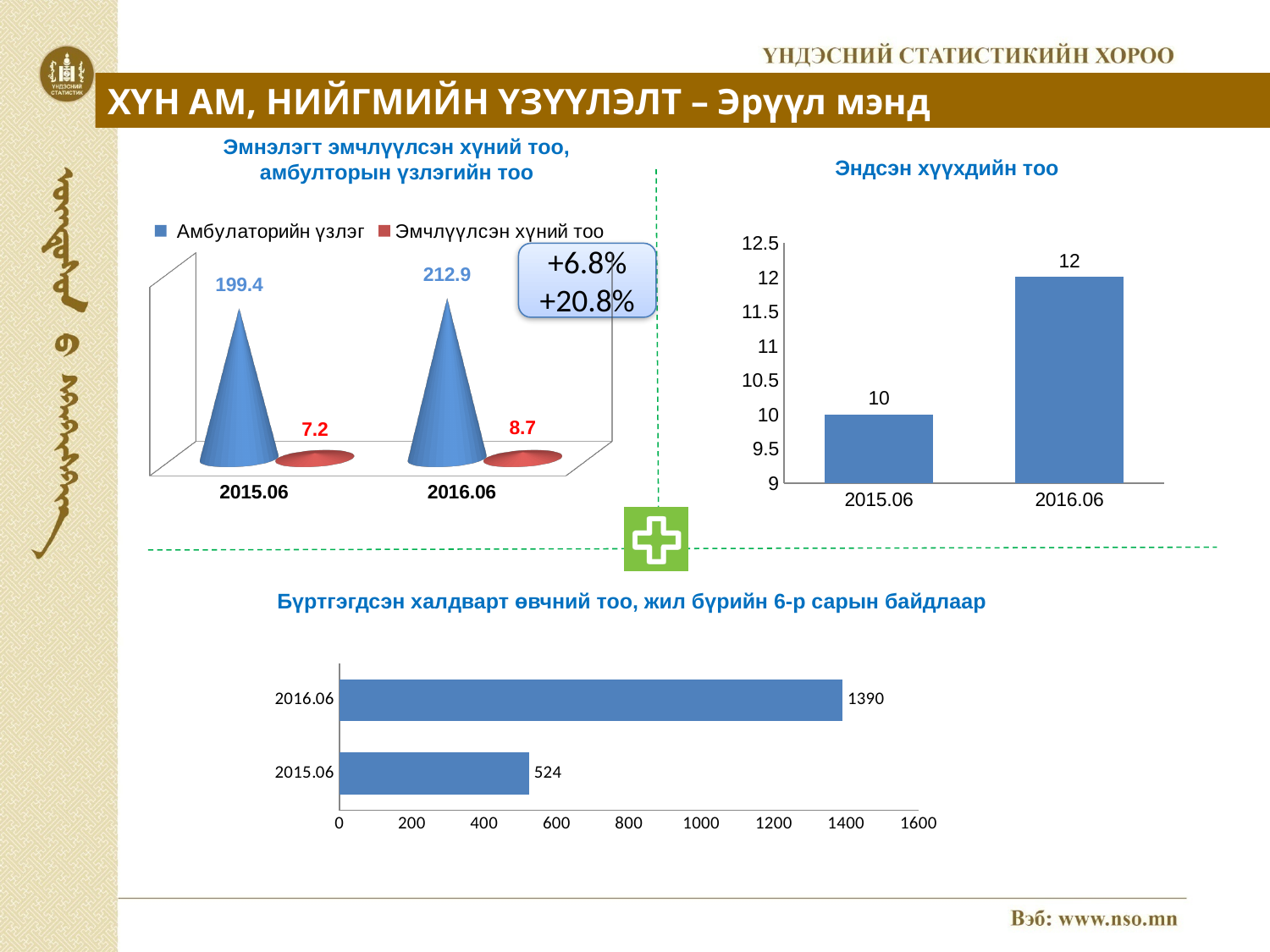
In the bottom chart titled 'Бүртгэгдсэн халдварт өвчний тоо, жил бүрийн 6-р сарын байдлаар', what is the value for 2015.06? 524 In the chart titled 'Эндсэн хүүхдийн тоо', what is the difference between the 2016.06 and 2015.06 values? 2 In the top-left chart titled 'Эмнэлэгт эмчлүүлсэн хүний тоо, амбулторын үзлэгийн тоо', what is the value of 'Эмчлүүлсэн хүний тоо' for 2015.06? 7.2 In the bottom chart titled 'Бүртгэгдсэн халдварт өвчний тоо, жил бүрийн 6-р сарын байдлаар', what is the value for 2016.06? 1390 In the top-left chart titled 'Эмнэлэгт эмчлүүлсэн хүний тоо, амбулторын үзлэгийн тоо', what is the value of 'Амбулаторийн үзлэг' for 2016.06? 212.9 In the top-left chart titled 'Эмнэлэгт эмчлүүлсэн хүний тоо, амбулторын үзлэгийн тоо', what is the difference in 'Амбулаторийн үзлэг' between 2016.06 and 2015.06? 13.5 In the chart titled 'Эндсэн хүүхдийн тоо', do the values rise or fall from 2015.06 to 2016.06? Rise In the bottom chart titled 'Бүртгэгдсэн халдварт өвчний тоо, жил бүрийн 6-р сарын байдлаар', what is the difference between the 2016.06 and 2015.06 values? 866 In the chart titled 'Эндсэн хүүхдийн тоо', what is the value for 2016.06? 12 In the chart titled 'Эндсэн хүүхдийн тоо', what is the value for 2015.06? 10 What kind of chart is the bottom chart titled 'Бүртгэгдсэн халдварт өвчний тоо, жил бүрийн 6-р сарын байдлаар'? Bar chart In the top-left chart titled 'Эмнэлэгт эмчлүүлсэн хүний тоо, амбулторын үзлэгийн тоо', how many series does the legend list? 2